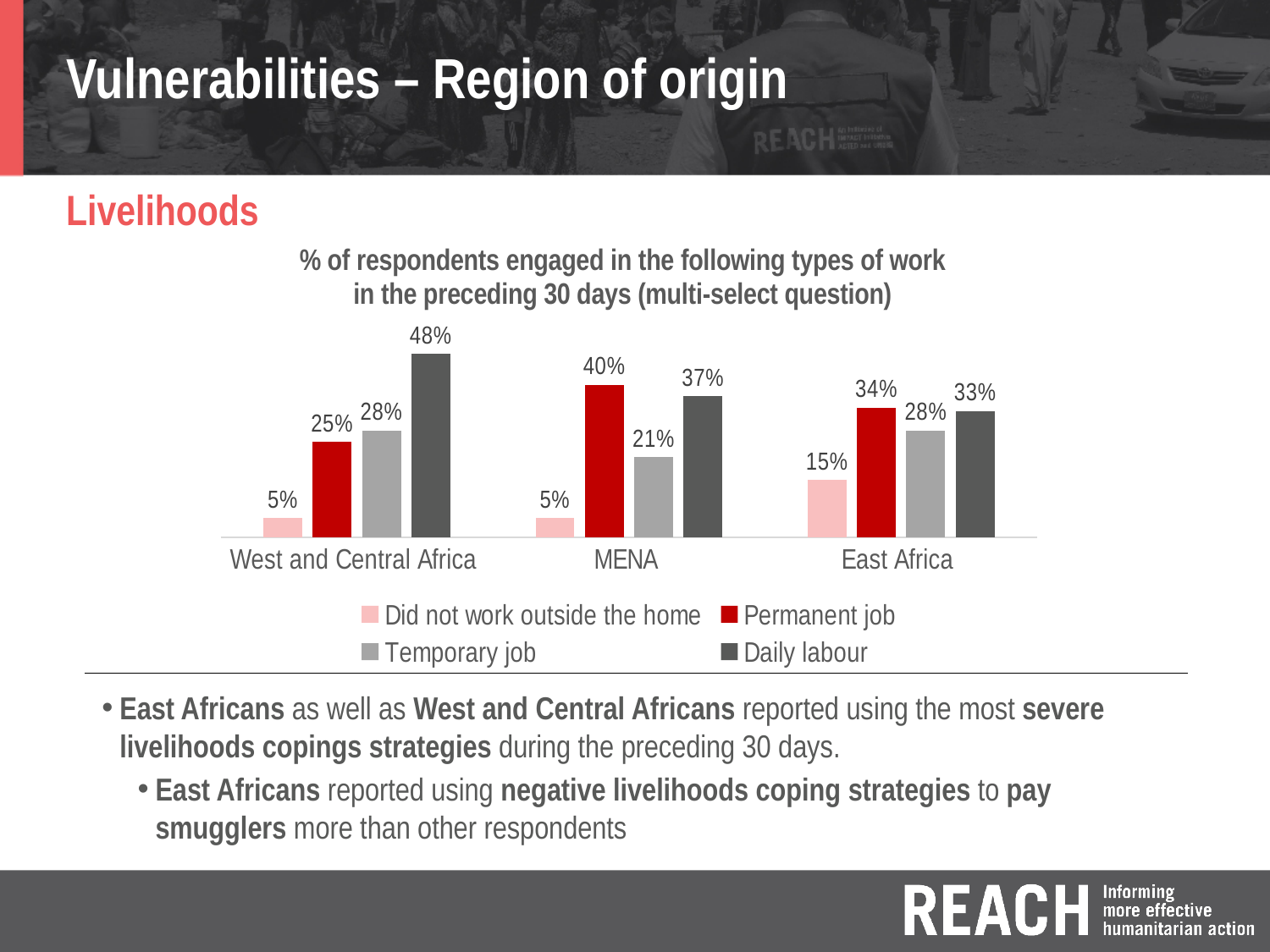
How many regions are shown on the x axis? 3 How many series does the legend list? 4 Which region has the highest value for daily labour? West and Central Africa Which is larger for MENA: temporary job or daily labour? Daily labour What kind of chart is shown on the slide? Bar chart What percentage of East Africa respondents did not work outside the home? 15% What is the title of the chart? % of respondents engaged in the following types of work in the preceding 30 days (multi-select question) What percentage of respondents from West and Central Africa reported daily labour? 48% What is the difference between the permanent job values for MENA and West and Central Africa? 15% Which colour represents the 'Permanent job' series in the legend? Red What percentage of MENA respondents reported having a permanent job? 40% Which region has the lowest value for permanent job? West and Central Africa